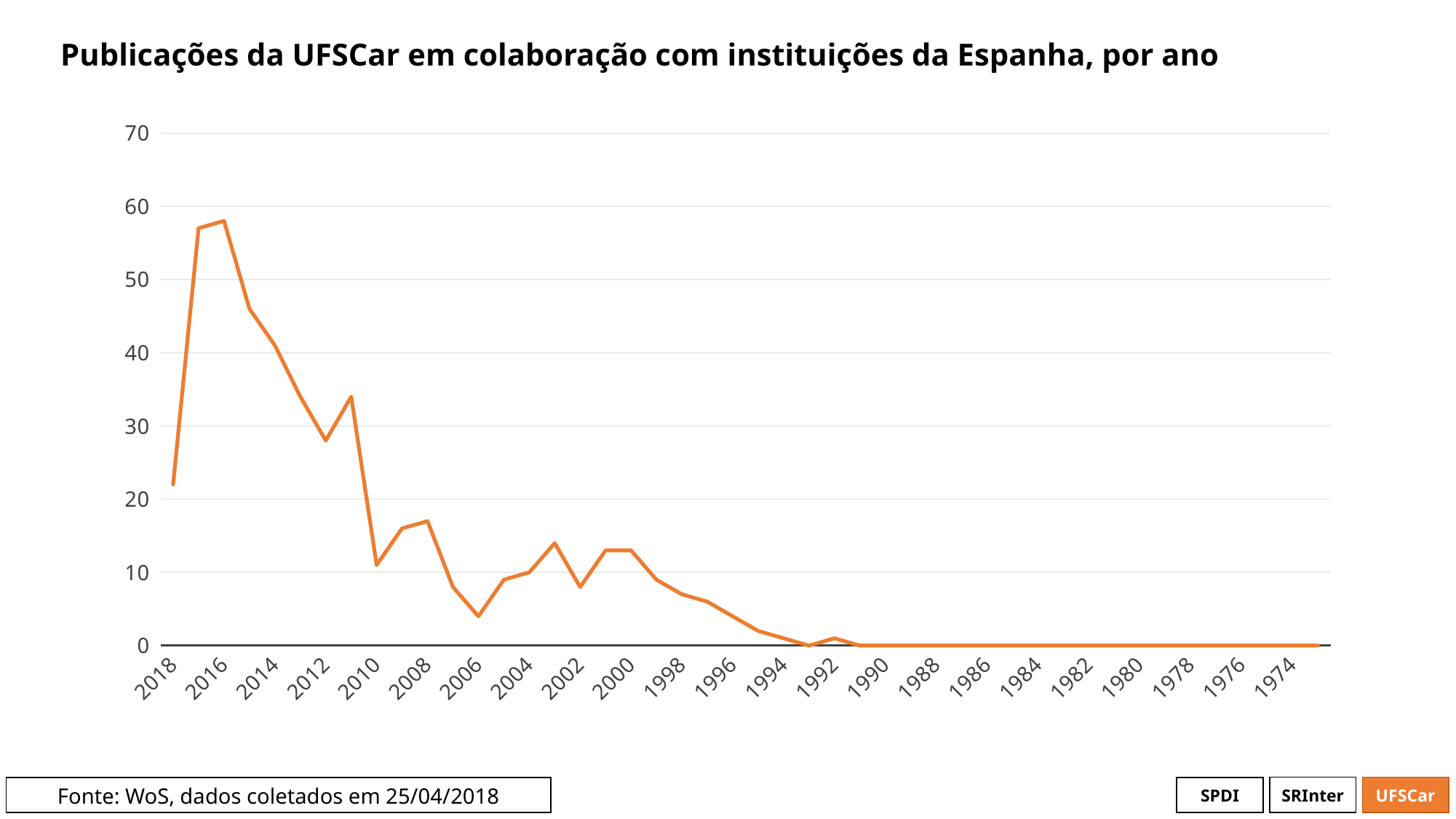
Is the value for 2018 greater or less than 30? less What is the title of the chart? Publicações da UFSCar em colaboração com instituições da Espanha, por ano How many year labels are shown on the x axis? 23 Is the value for 2016 greater or less than 50? greater What colour is the line in the chart? orange Is the value for 2006 greater or less than 10? less Do the values generally rise or fall from 2016 to 2010? fall Which is larger, the value for 2016 or the value for 2010? 2016 What kind of chart is shown on the slide? line chart